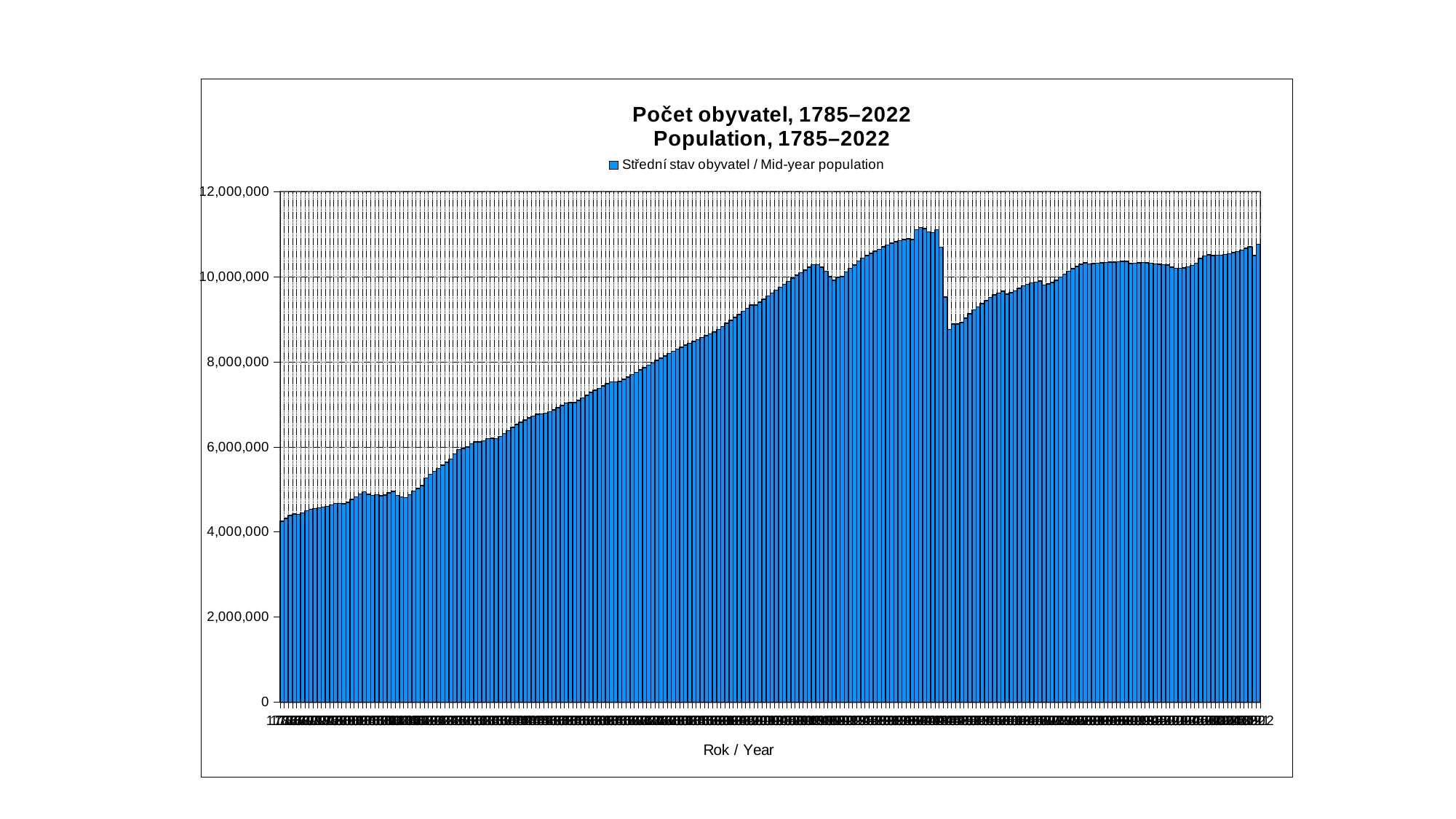
Is the value for the first bar (1785) greater or less than 6,000,000? less What is the title of the chart? Počet obyvatel, 1785–2022 Population, 1785–2022 Is the highest bar on the chart greater or less than 12,000,000? less How many series does the legend list? 1 Is the value for the last bar (2022) greater or less than 10,000,000? greater What kind of chart is shown on the slide? bar chart Is the value for the last bar (2022) larger or smaller than the value for the first bar (1785)? larger What is the x-axis title of the chart? Rok / Year Do the values generally rise or fall from left to right along the x axis? rise